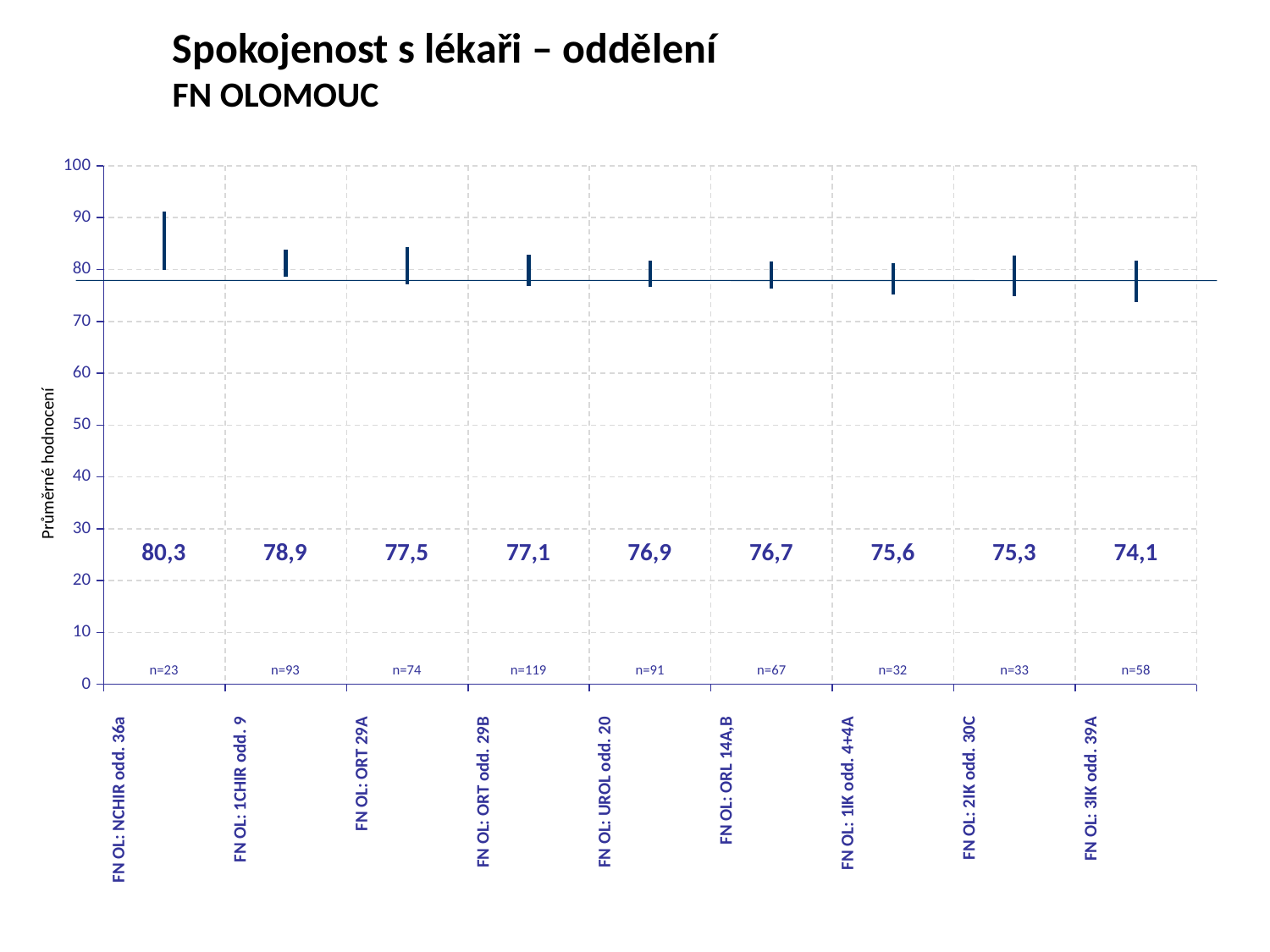
Which department has the lowest average rating? FN OL: 3IK odd. 39A What is the label of the vertical axis? Průměrné hodnocení Which department has the smallest number of respondents (n)? FN OL: NCHIR odd. 36a Which has a higher average rating, FN OL: 1CHIR odd. 9 or FN OL: UROL odd. 20? FN OL: 1CHIR odd. 9 What is the average rating (průměrné hodnocení) for FN OL: NCHIR odd. 36a? 80,3 What is the difference between the average ratings of FN OL: NCHIR odd. 36a and FN OL: 3IK odd. 39A? 6,2 What is the average rating shown for FN OL: 3IK odd. 39A? 74,1 Which department has the highest average rating? FN OL: NCHIR odd. 36a What is the average rating shown for FN OL: ORT odd. 29B? 77,1 How many departments are shown on the chart? 9 Do the average ratings rise or fall from left to right along the x axis? fall What is the n value (number of respondents) shown for FN OL: ORT odd. 29B? n=119